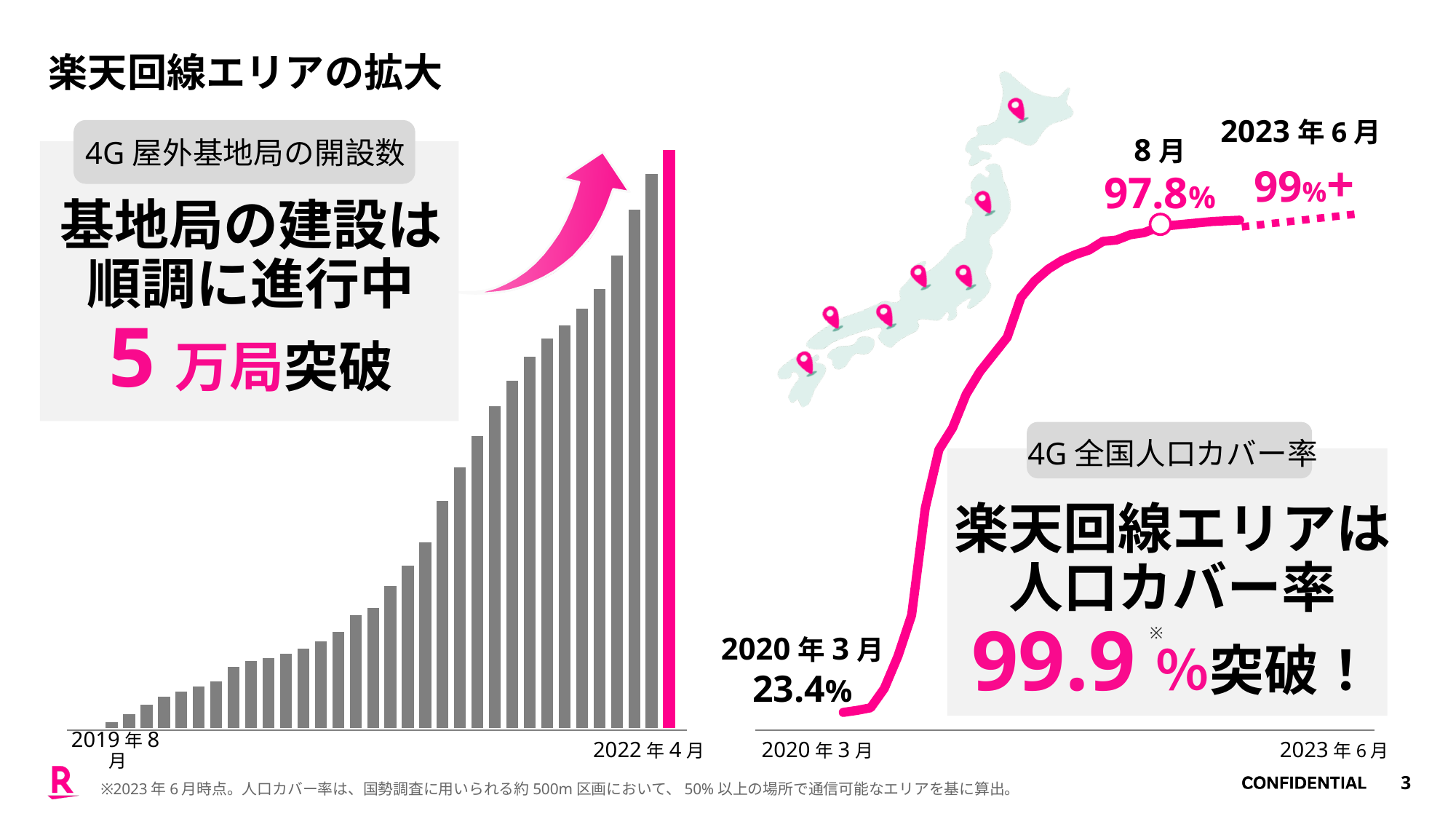
In the 4G 全国人口カバー率 chart, what is the coverage rate shown at the 8月 point? 97.8% In the 4G 全国人口カバー率 chart, what is the coverage rate shown for 2020年3月? 23.4% In the 4G 屋外基地局の開設数 bar chart, which period has the tallest bar? 2022年4月 In the 4G 屋外基地局の開設数 bar chart, do the bars rise or fall from 2019年8月 to 2022年4月? rise What kind of chart is the chart on the right of the slide (4G 全国人口カバー率)? line chart What is the title of the chart on the left of the slide? 4G 屋外基地局の開設数 What kind of chart is the chart on the left of the slide (4G 屋外基地局の開設数)? bar chart In the 4G 全国人口カバー率 chart, do the values rise or fall from 2020年3月 to 2023年6月? rise What is the title of the chart on the right of the slide? 4G 全国人口カバー率 In the 4G 全国人口カバー率 chart, which is larger: the value at 2020年3月 or the value at 8月? 8月 In the 4G 全国人口カバー率 chart, what value is shown for 2023年6月? 99%+ In the 4G 全国人口カバー率 chart, by how many percentage points did the coverage rate increase from 2020年3月 (23.4%) to the 8月 point (97.8%)? 74.4 percentage points